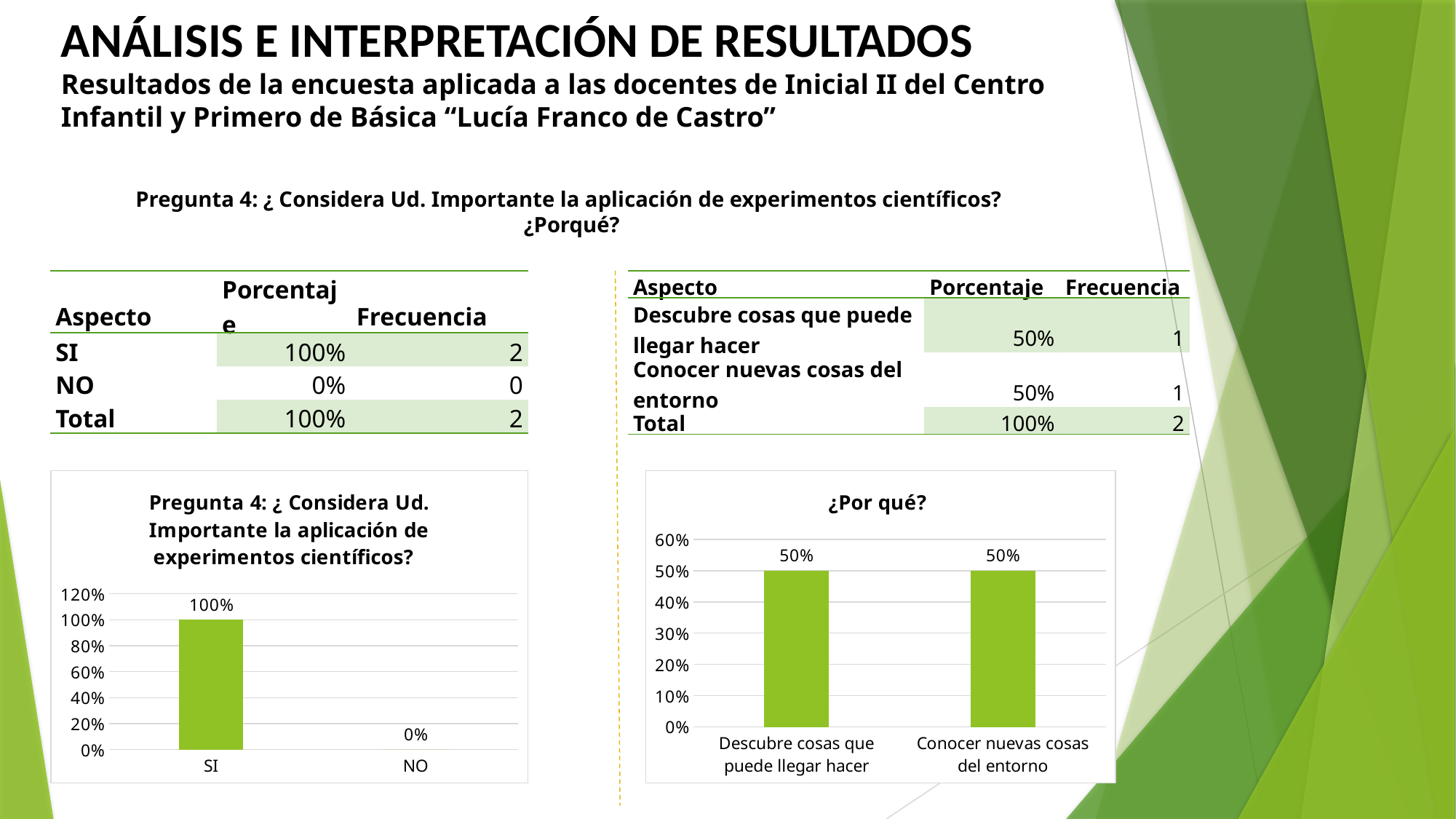
In the right chart (¿Por qué?), what is the value for 'Descubre cosas que puede llegar hacer'? 50% In the right chart (¿Por qué?), what is the value for 'Conocer nuevas cosas del entorno'? 50% In the left chart (Pregunta 4), which category has the highest value? SI In the left chart (Pregunta 4), what is the difference between the values for SI and NO? 100% In the right chart (¿Por qué?), what is the difference between the two bars? 0% In the left chart (Pregunta 4), which category has the lowest value? NO In the left chart (Pregunta 4), how many categories are shown on the x axis? 2 In the left chart (Pregunta 4), what is the value for NO? 0% In the left chart (Pregunta 4), what kind of chart is it? bar chart In the right chart (¿Por qué?), what is the highest value shown on the y axis? 60% In the right chart (¿Por qué?), how many bars are shown? 2 In the left chart (Pregunta 4), what is the value for SI? 100%